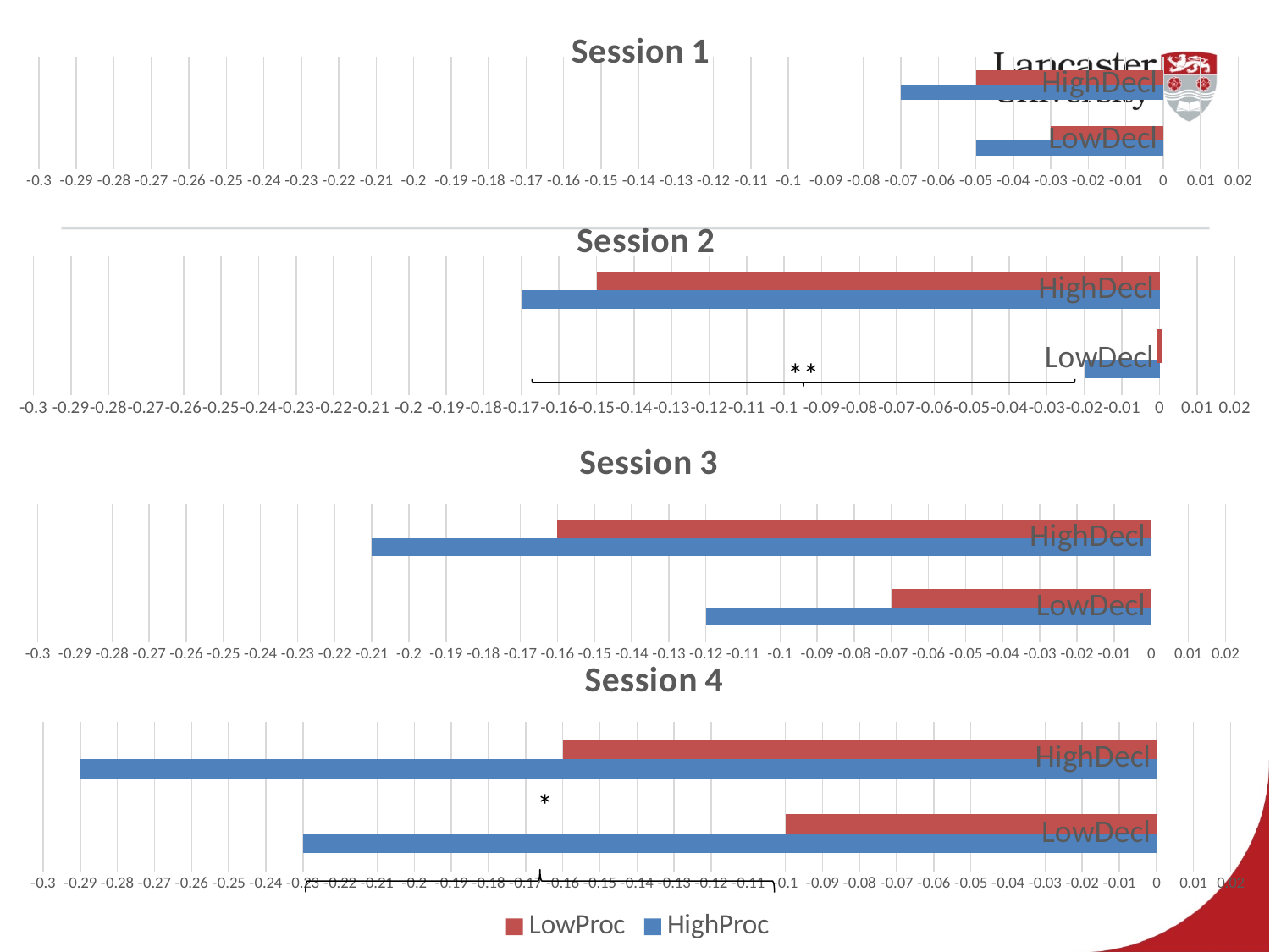
How many series does the legend at the bottom of the slide list? 2 In the Session 4 chart, is the HighProc value for HighDecl greater or less than -0.2? less In the Session 4 chart, which series has the lower value for HighDecl, LowProc or HighProc? HighProc In the Session 3 chart, which category has the lower HighProc value, HighDecl or LowDecl? HighDecl In the Session 3 chart, is the HighProc value for HighDecl greater or less than -0.1? less In the Session 2 chart, is the HighProc value for LowDecl greater or less than -0.1? greater Which series is shown in blue in the legend? HighProc In the Session 2 chart, which category has the lower LowProc value, HighDecl or LowDecl? HighDecl How many categories are plotted in the Session 3 chart? 2 What kind of chart is used for Session 1? bar chart